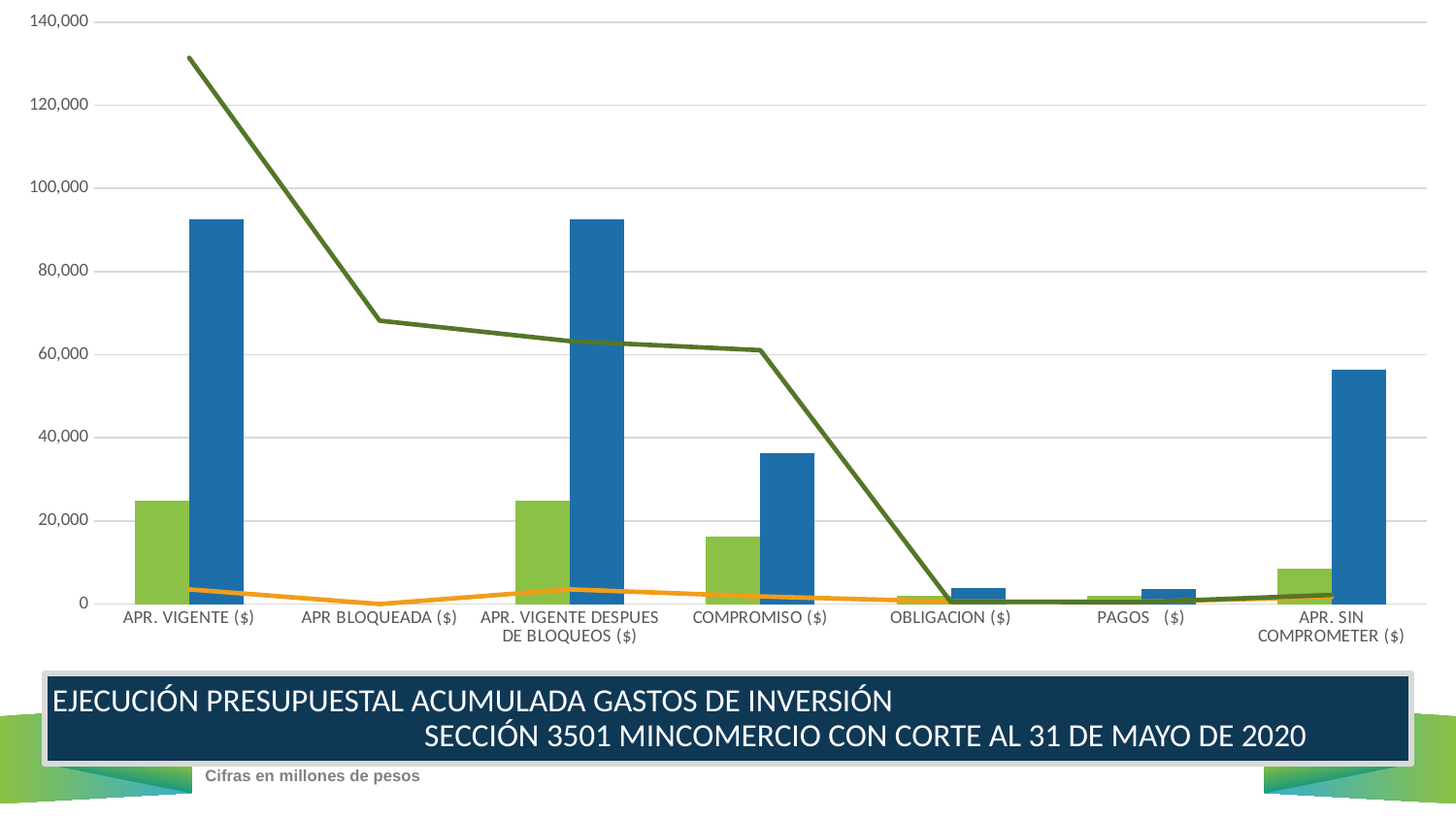
At which category does the green line reach its highest value? APR. VIGENTE ($) Which has the taller blue bar: COMPROMISO ($) or APR. SIN COMPROMETER ($)? APR. SIN COMPROMETER ($) Is the value of the blue bar for COMPROMISO ($) greater or less than 40,000? less Does the green line rise or fall from APR. VIGENTE ($) to OBLIGACION ($)? fall What kind of chart is this? Combination bar and line chart In what units are the figures in the chart expressed, according to the note below the title? Millones de pesos What is the highest value shown on the y axis of the chart? 140,000 Is the value of the blue bar for APR. SIN COMPROMETER ($) greater or less than 60,000? less How many categories are shown on the x axis of the chart? 7 Is the value of the green bar for COMPROMISO ($) greater or less than 20,000? less